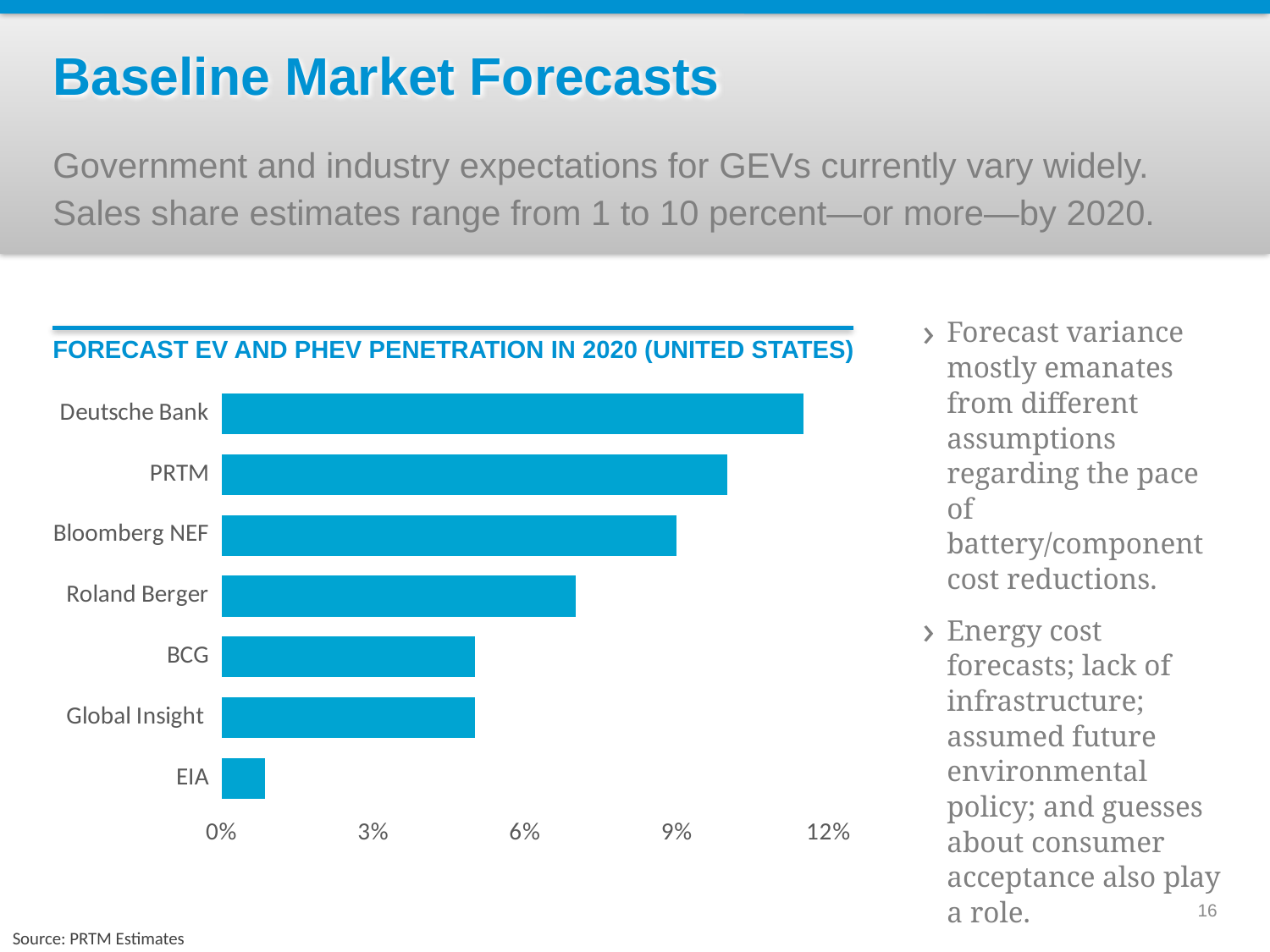
What kind of chart is shown on the slide? Bar chart Which source has the lowest forecast EV and PHEV penetration in 2020? EIA Which is larger, the forecast from PRTM or the forecast from Roland Berger? PRTM Is the value for Deutsche Bank greater or less than 12%? less What is the title of the chart? FORECAST EV AND PHEV PENETRATION IN 2020 (UNITED STATES) Is the value for PRTM greater or less than 9%? greater Is the value for Roland Berger greater or less than 6%? greater How many sources (bars) are shown in the chart? 7 Which source has the highest forecast EV and PHEV penetration in 2020? Deutsche Bank Which is larger, the forecast from Bloomberg NEF or the forecast from Global Insight? Bloomberg NEF